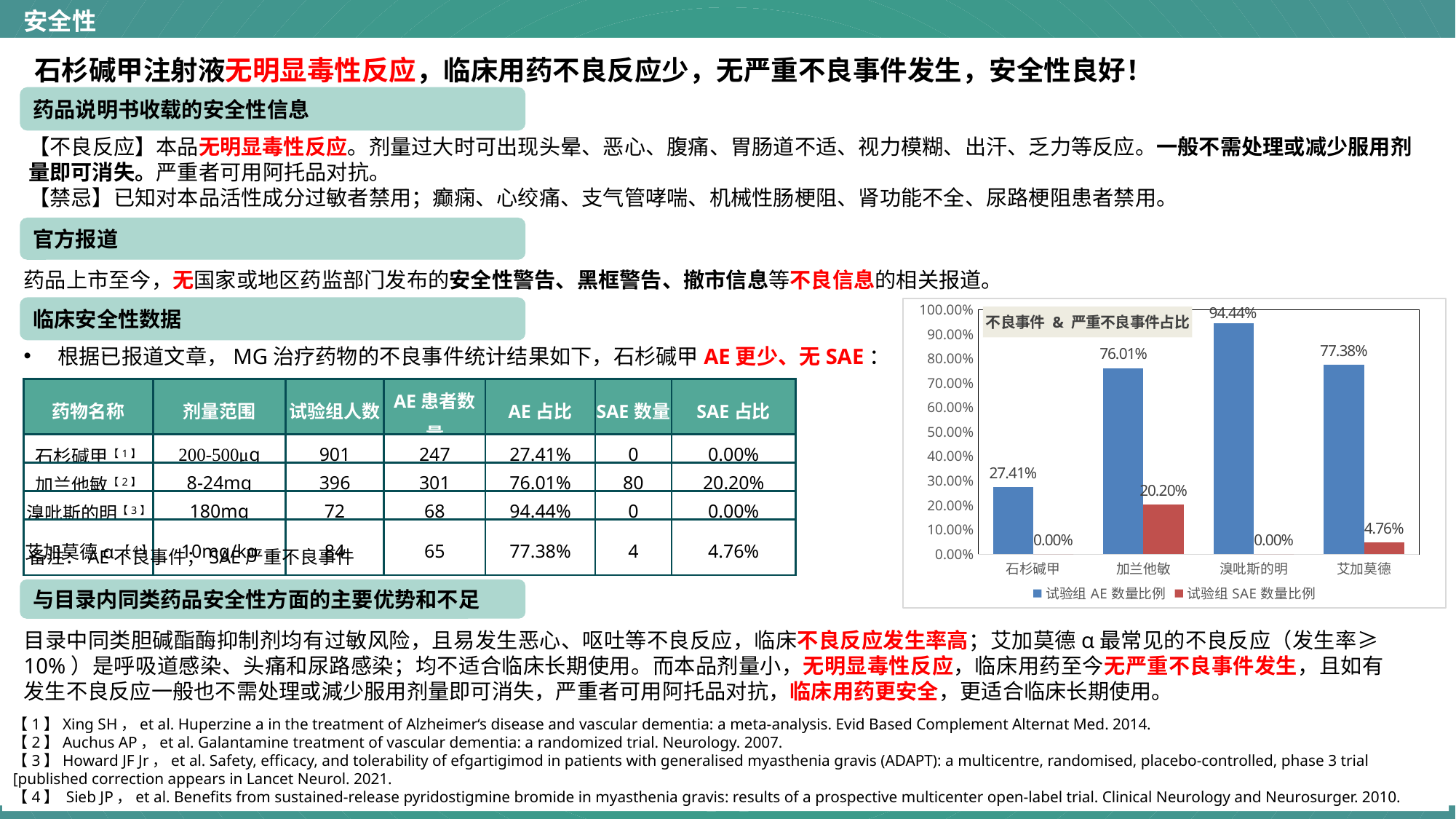
Which drug has the highest 试验组 AE 数量比例 in the chart? 溴吡斯的明 What is the 试验组 AE 数量比例 value for 艾加莫德 in the chart? 77.38% What type of chart is shown on the slide? bar chart How many drugs are shown on the x axis of the chart? 4 What is the 试验组 AE 数量比例 value for 石杉碱甲 in the chart? 27.41% What is the difference between the 试验组 AE 数量比例 of 溴吡斯的明 and 石杉碱甲? 67.03% Which is larger: the 试验组 SAE 数量比例 for 加兰他敏 or for 艾加莫德? 加兰他敏 How many series does the chart legend list? 2 What is the title of the chart? 不良事件 & 严重不良事件占比 What is the 试验组 SAE 数量比例 value for 加兰他敏 in the chart? 20.20% Which drug has the lowest 试验组 AE 数量比例 in the chart? 石杉碱甲 Is the 试验组 AE 数量比例 for 加兰他敏 greater or less than 70.00%? greater